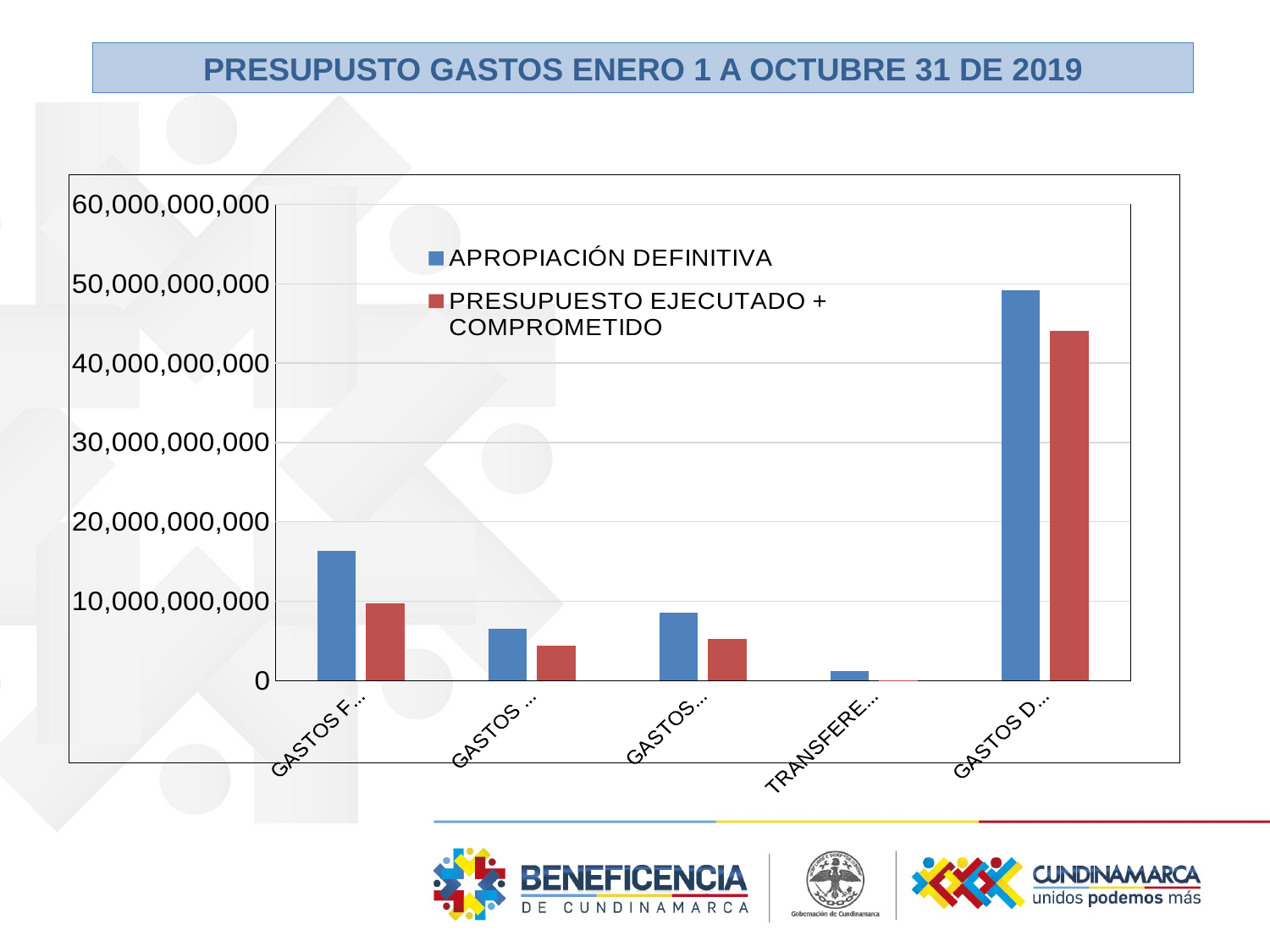
What is the title of the slide? PRESUPUSTO GASTOS ENERO 1 A OCTUBRE 31 DE 2019 What kind of chart is shown on the slide? bar chart Which category has the lowest PRESUPUESTO EJECUTADO + COMPROMETIDO value? TRANSFERE... (the fourth category) Is the PRESUPUESTO EJECUTADO + COMPROMETIDO value for the fifth category (GASTOS D...) greater or less than 40,000,000,000? greater Which colour represents the PRESUPUESTO EJECUTADO + COMPROMETIDO series? red Is the APROPIACIÓN DEFINITIVA value for the fourth category (TRANSFERE...) greater or less than 10,000,000,000? less How many categories are plotted along the x axis? 5 How many series does the legend list? 2 For the first category (GASTOS F...), which is larger: APROPIACIÓN DEFINITIVA or PRESUPUESTO EJECUTADO + COMPROMETIDO? APROPIACIÓN DEFINITIVA Is the APROPIACIÓN DEFINITIVA value for the first category (GASTOS F...) greater or less than 10,000,000,000? greater Which category has the highest APROPIACIÓN DEFINITIVA value? GASTOS D... (the fifth category)